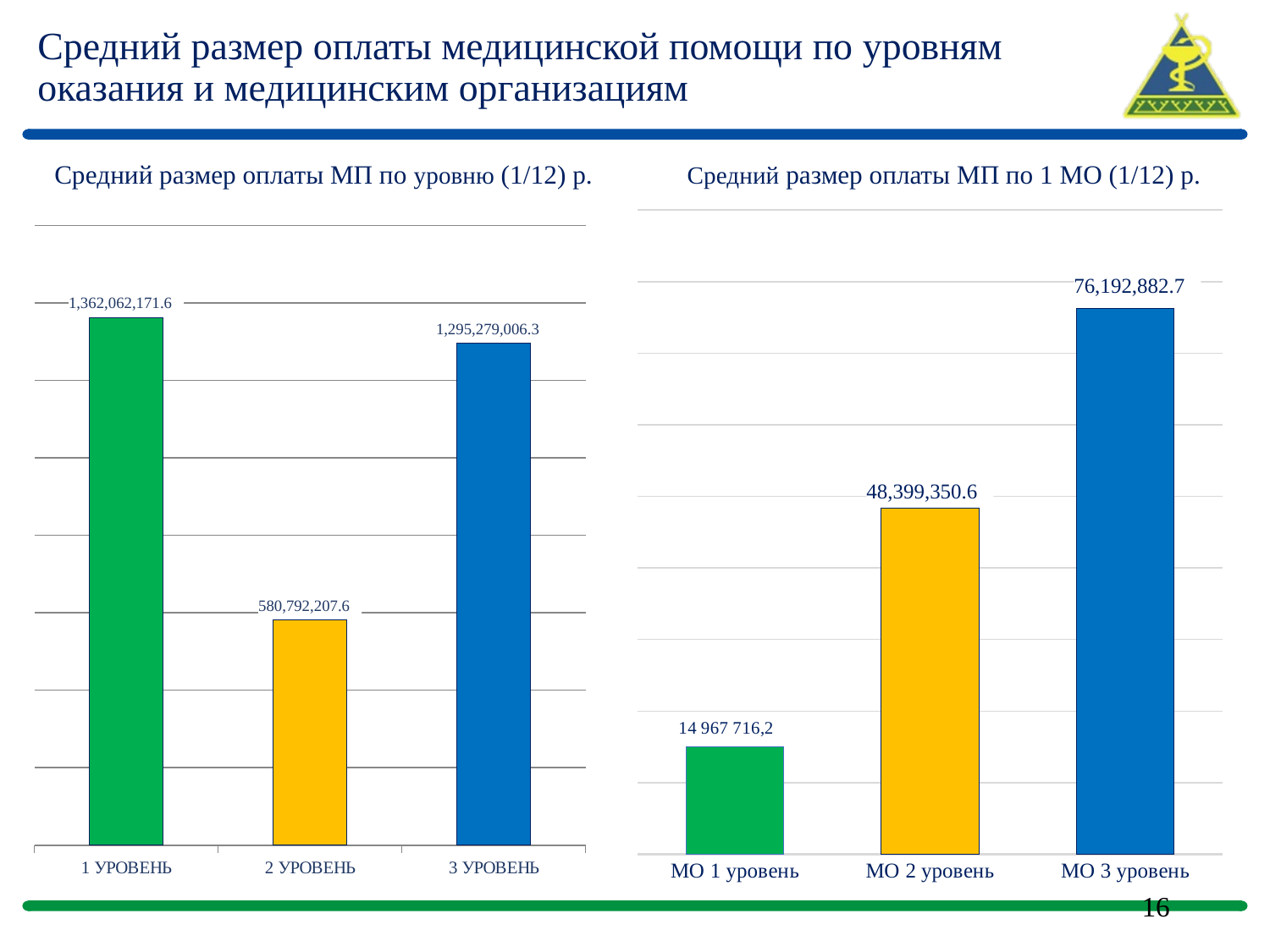
In the right chart (Средний размер оплаты МП по 1 МО), which category has the lowest value? МО 1 уровень In the right chart (Средний размер оплаты МП по 1 МО), what is the difference between the values for МО 3 уровень and МО 2 уровень? 27,793,532.1 In the left chart (Средний размер оплаты МП по уровню), what is the value for 3 УРОВЕНЬ? 1,295,279,006.3 What type of chart is the left chart (Средний размер оплаты МП по уровню)? bar chart In the right chart (Средний размер оплаты МП по 1 МО), do the values rise or fall from МО 1 уровень to МО 3 уровень? rise In the left chart (Средний размер оплаты МП по уровню), which category has the lowest value? 2 УРОВЕНЬ In the left chart (Средний размер оплаты МП по уровню), what is the value for 1 УРОВЕНЬ? 1,362,062,171.6 In the left chart (Средний размер оплаты МП по уровню), what is the difference between the values for 1 УРОВЕНЬ and 2 УРОВЕНЬ? 781,269,964.0 In the left chart (Средний размер оплаты МП по уровню), what is the value for 2 УРОВЕНЬ? 580,792,207.6 In the right chart (Средний размер оплаты МП по 1 МО), what is the value for МО 1 уровень? 14 967 716,2 In the right chart (Средний размер оплаты МП по 1 МО), what is the value for МО 3 уровень? 76,192,882.7 In the right chart (Средний размер оплаты МП по 1 МО), which category has the highest value? МО 3 уровень